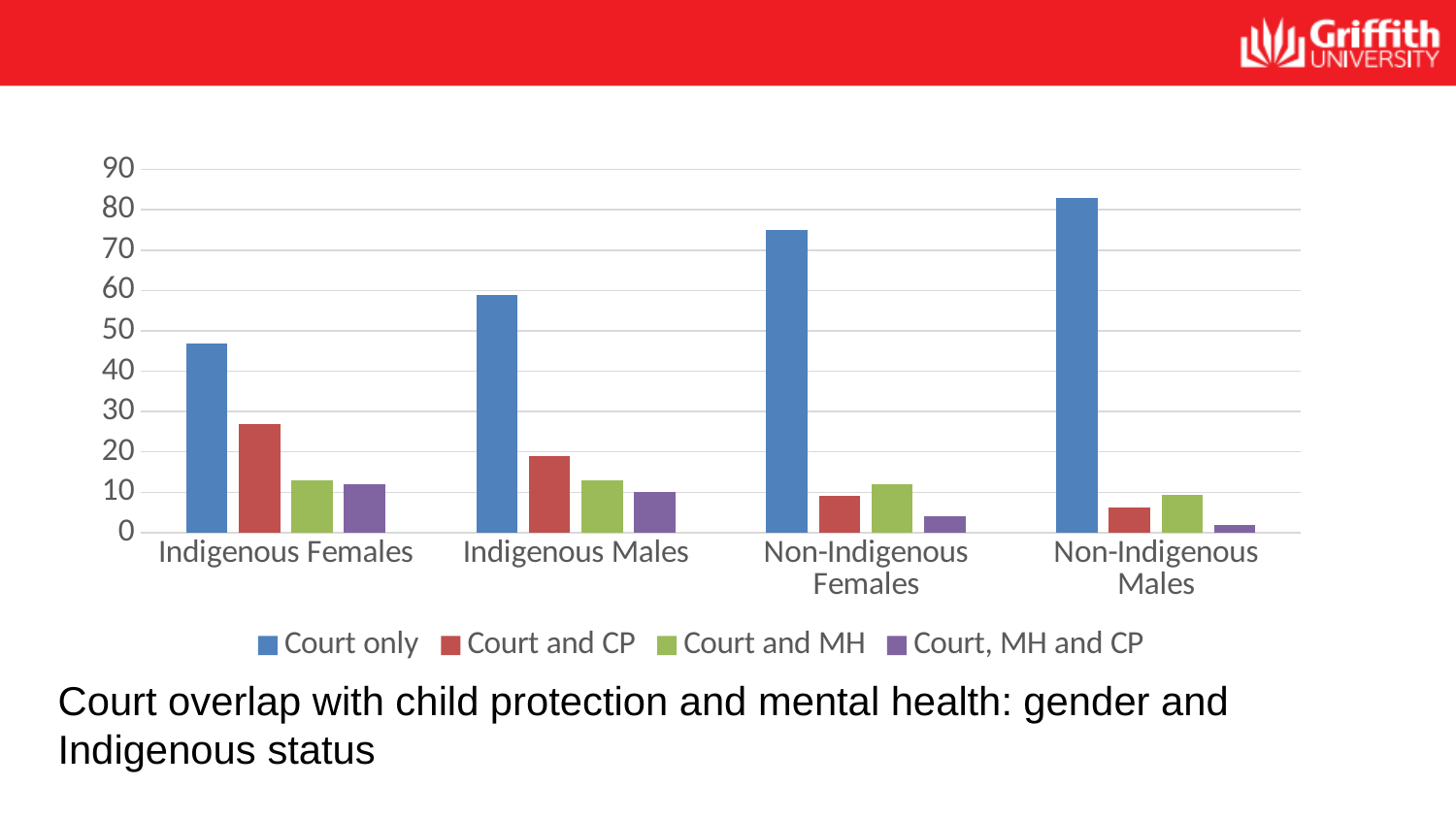
Is the Court and CP value for Indigenous Females greater or less than 20? greater Which category has the highest value for Court only? Non-Indigenous Males How many categories are shown on the x axis? 4 Is the Court only value for Non-Indigenous Males greater or less than 80? greater Is the Court only value for Indigenous Females greater or less than 50? less What kind of chart is shown on the slide? bar chart Which category has the highest value for Court and CP? Indigenous Females Which category has the lowest value for Court, MH and CP? Non-Indigenous Males Which is larger: the Court and CP value for Indigenous Females or for Indigenous Males? Indigenous Females How many series does the legend list? 4 Which category has the lowest value for Court only? Indigenous Females Do the Court only values rise or fall moving from left to right across the categories? rise